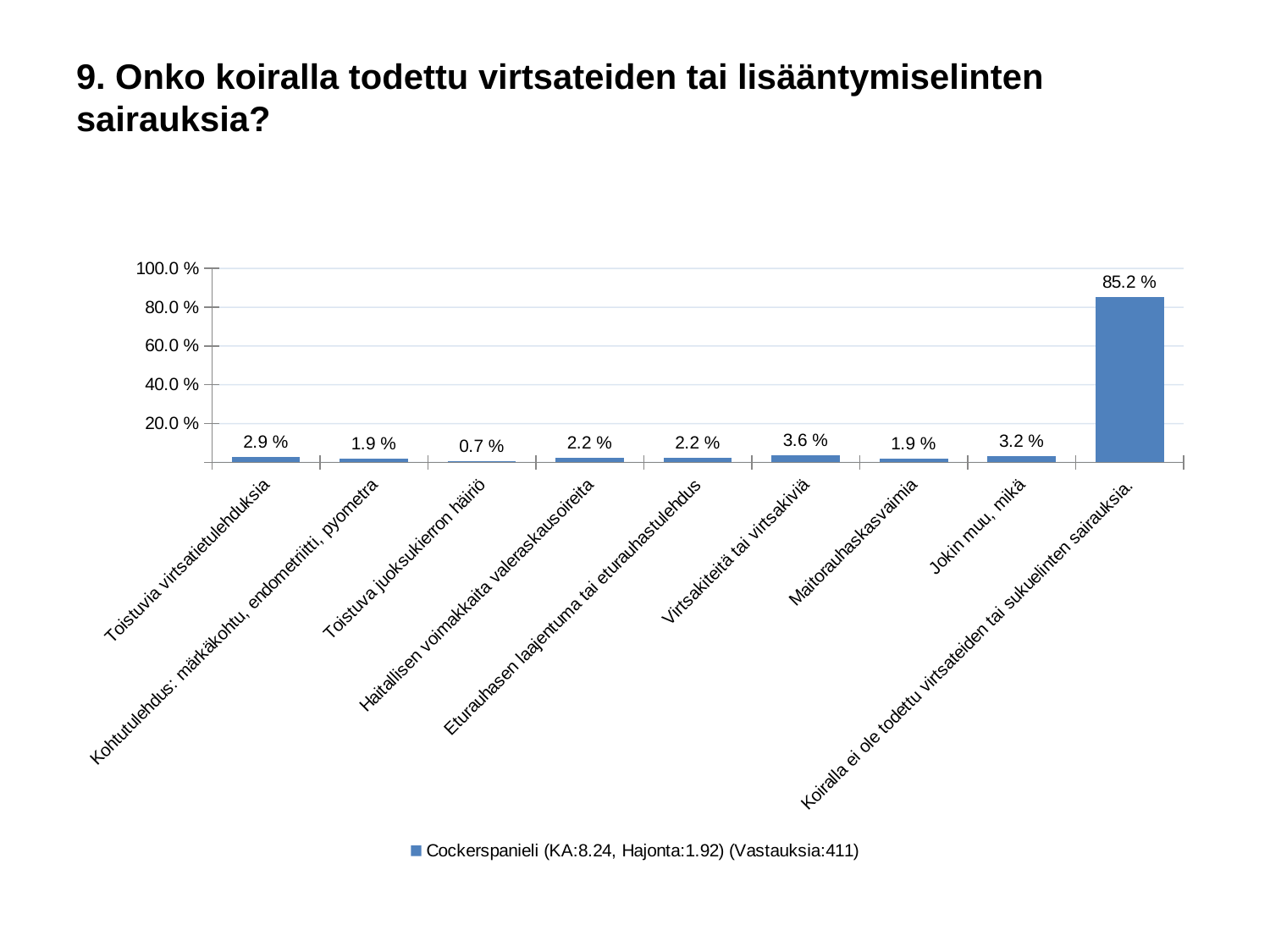
What is the value for "Virtsakiteitä tai virtsakiviä"? 3.6 % How many categories are shown on the x axis? 9 What is the value for "Toistuva juoksukierron häiriö"? 0.7 % Which category has the lowest value? Toistuva juoksukierron häiriö What is the value for "Jokin muu, mikä"? 3.2 % Is the value for "Koiralla ei ole todettu virtsateiden tai sukuelinten sairauksia." greater or less than 80.0 %? greater Which category has the highest value? Koiralla ei ole todettu virtsateiden tai sukuelinten sairauksia. What is the difference between the values for "Virtsakiteitä tai virtsakiviä" and "Toistuvia virtsatietulehduksia"? 0.7 % What kind of chart is shown on the slide? bar chart What is the legend entry for the series? Cockerspanieli (KA:8.24, Hajonta:1.92) (Vastauksia:411) What is the value for "Koiralla ei ole todettu virtsateiden tai sukuelinten sairauksia."? 85.2 % Which is larger, the value for "Jokin muu, mikä" or the value for "Maitorauhaskasvaimia"? Jokin muu, mikä